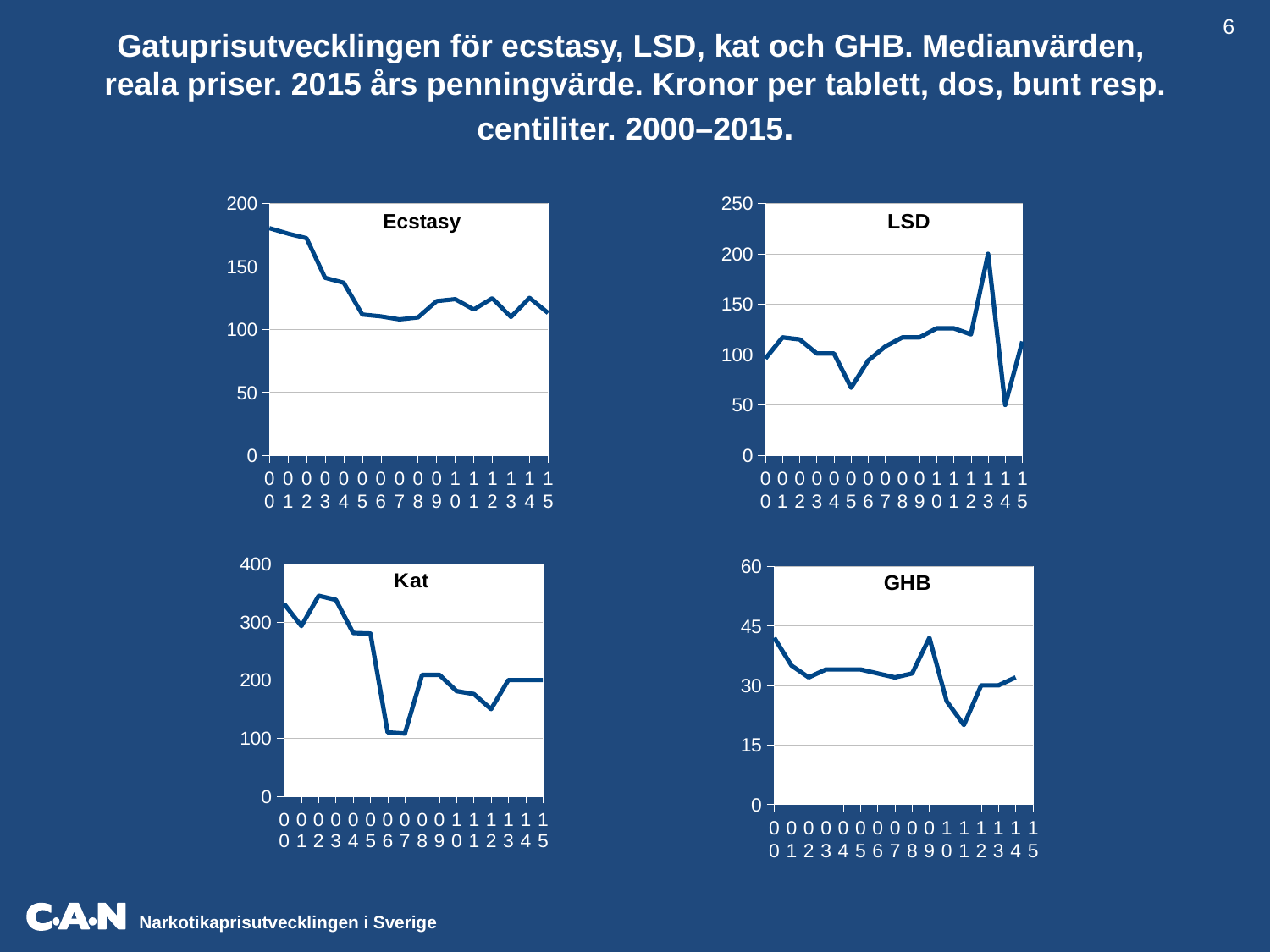
In the LSD chart, which year has the lowest value? 14 (2014) How many charts are shown on the slide? 4 In the LSD chart, is the value for 13 (2013) greater or less than 150? greater In the Ecstasy chart, is the value for 00 (2000) greater or less than 150? greater In the Ecstasy chart, which year has the highest value? 00 (2000) In the Ecstasy chart, is the value for 15 (2015) greater or less than 150? less How many data points (years) are plotted in the GHB chart? 15 What kind of chart is the Ecstasy chart? line chart In the GHB chart, which year has the lowest value? 11 (2011) In the Ecstasy chart, do the values overall rise or fall from 2000 to 2015? fall In the LSD chart, which year has the highest value? 13 (2013)